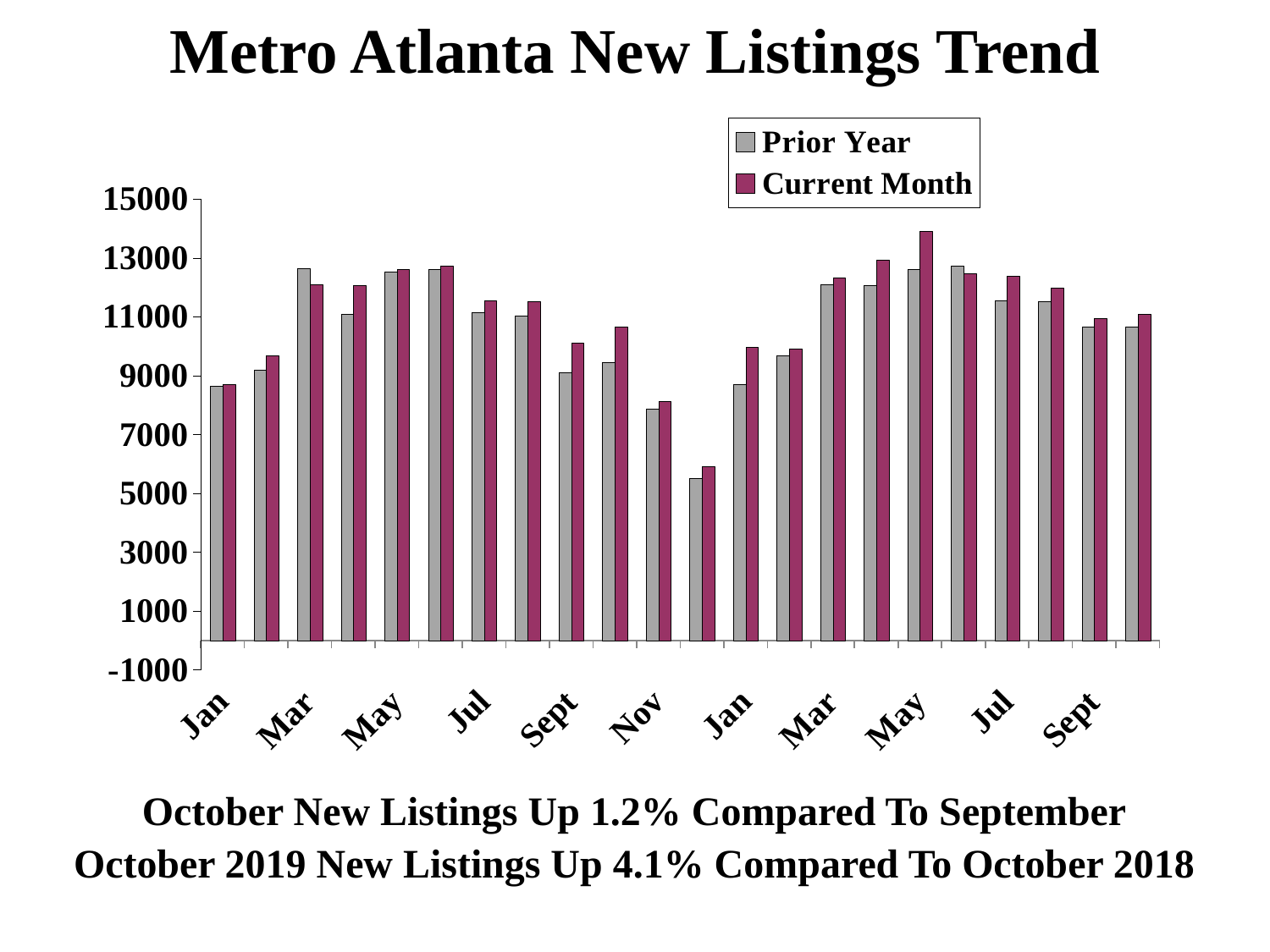
Is the Prior Year value for the first Sept greater or less than 11000? less How many series does the legend list? 2 For the first Mar, which is larger: Prior Year or Current Month? Prior Year Which series is drawn in grey bars? Prior Year Is the Current Month value for the first Jan greater or less than 9000? less Which month has the highest Current Month bar? May (second year) Is the Current Month value for the second May greater or less than 13000? greater What is the title of the chart? Metro Atlanta New Listings Trend For the second Jan, which is larger: Prior Year or Current Month? Current Month What kind of chart is shown on the slide? Bar chart